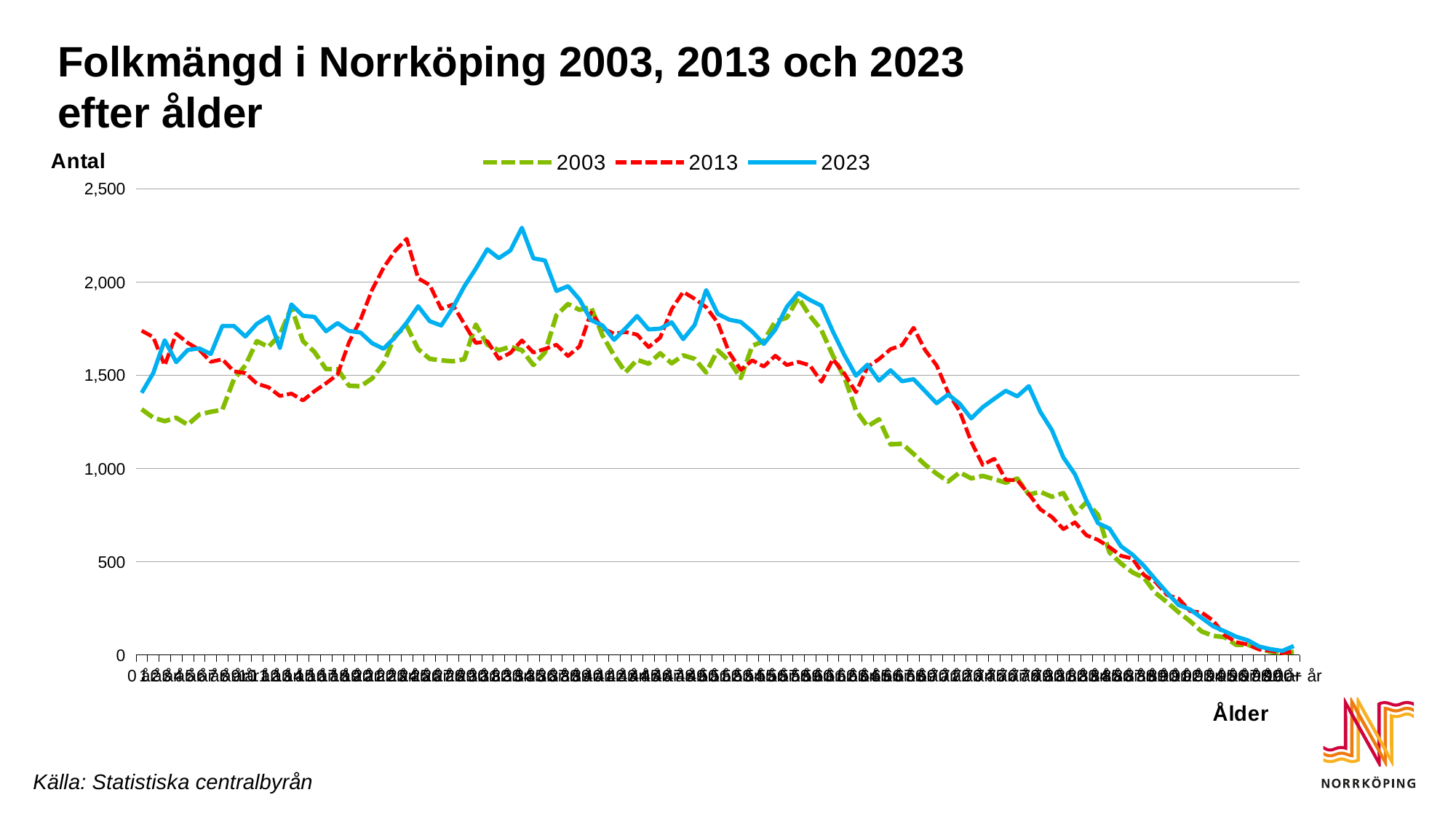
Is the value at the far right end of the 2023 line greater or less than 500? less Is the highest point of the 2003 line greater or less than 2,000? less Do the values of all three lines rise or fall toward the right-hand end of the x axis? fall What kind of chart is shown on the slide? line chart Is the highest point of the 2023 line greater or less than 2,000? greater How many series does the legend list? 3 What is the title of the chart? Folkmängd i Norrköping 2003, 2013 och 2023 efter ålder Which series has the lowest peak value on the chart? 2003 Which years are listed in the chart legend? 2003, 2013 and 2023 Which series reaches the highest value anywhere on the chart? 2023